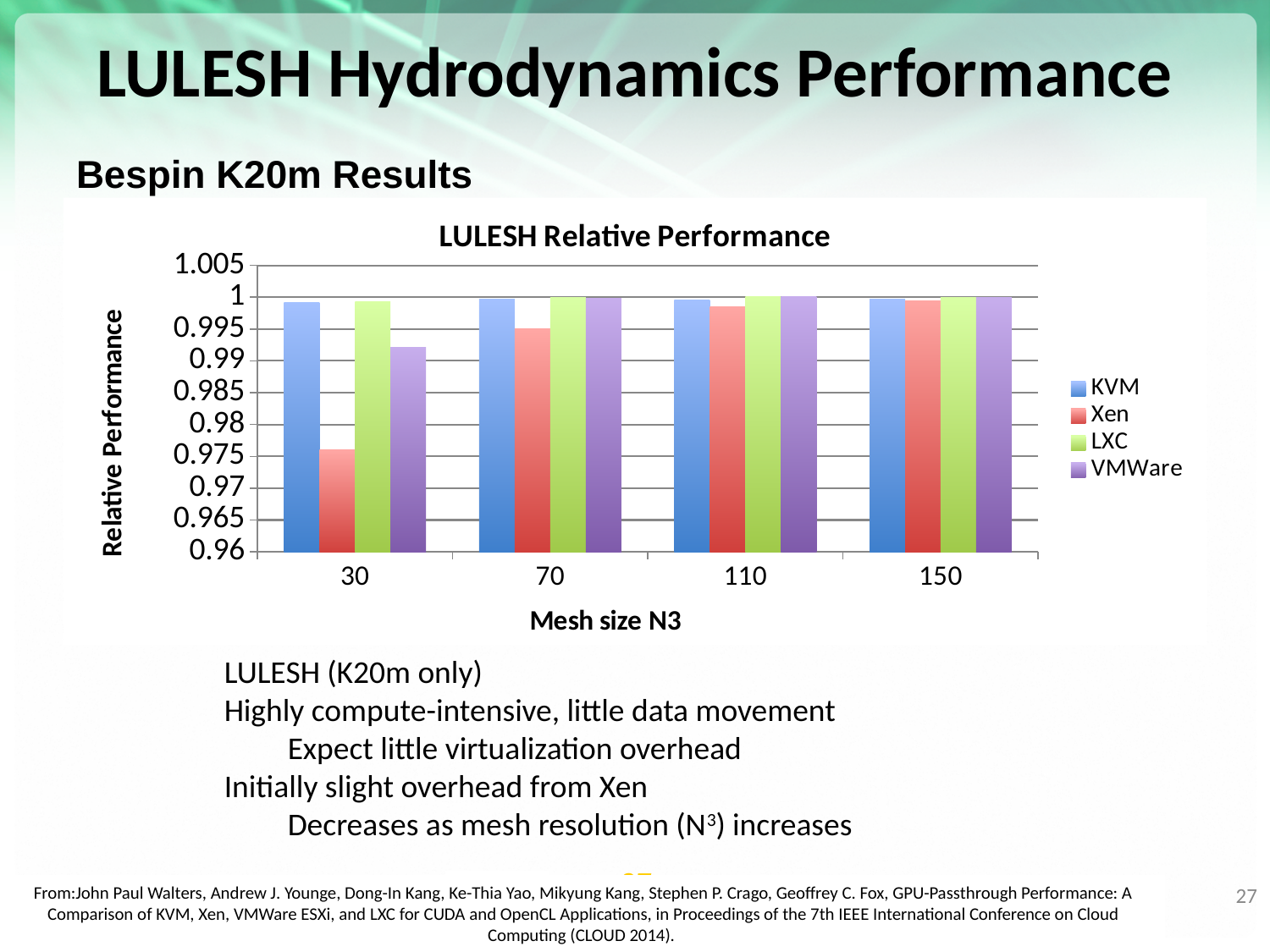
What kind of chart is shown on the slide? bar chart How many mesh size categories are shown on the x axis of the chart? 4 Is the value for Xen at mesh size 70 greater or less than 0.99? greater Is the value for VMWare at mesh size 30 greater or less than 0.995? less What is the label of the y axis of the chart? Relative Performance Do the Xen values rise or fall as mesh size increases along the x axis? rise How many series does the legend of the LULESH Relative Performance chart list? 4 Is the value for Xen at mesh size 30 greater or less than 0.97? greater At mesh size 30, which is larger, the KVM bar or the Xen bar? KVM At which mesh size is the Xen bar lowest? 30 Which series has the lowest bar at mesh size 30? Xen